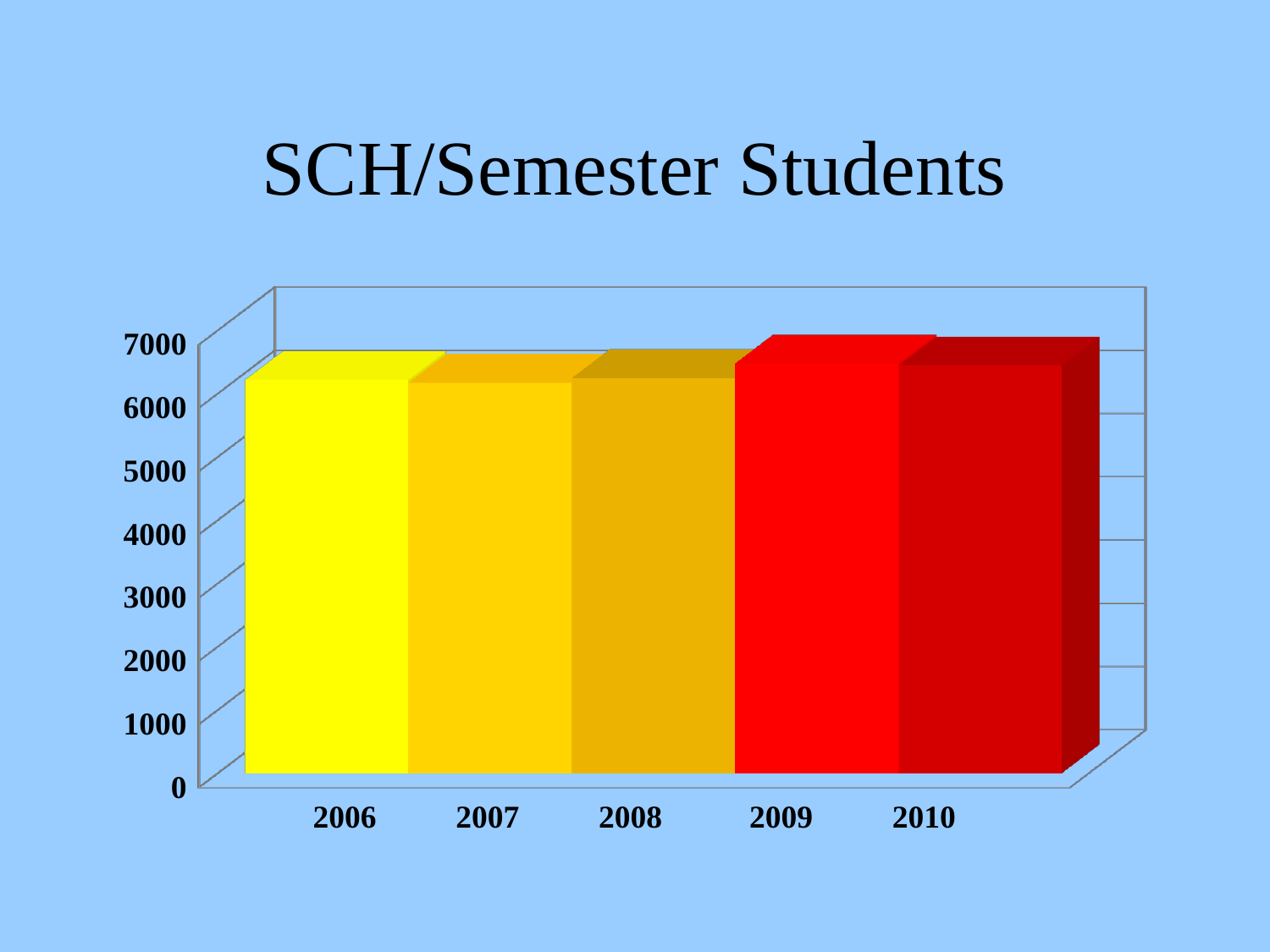
What colour are the bars for 2009 and 2010? Red Is the value for 2010 higher or lower than the value for 2006? higher Which is larger, the value for 2010 or the value for 2008? 2010 What is the title of the chart? SCH/Semester Students Is the value for 2009 greater or less than 6000? greater Which year has the highest bar in the chart? 2009 What kind of chart is shown on the slide? Bar chart How many years are shown on the x axis of the chart? 5 Is the value for 2008 greater or less than 7000? less Is the value for 2006 greater or less than 6000? greater Which is larger, the value for 2009 or the value for 2006? 2009